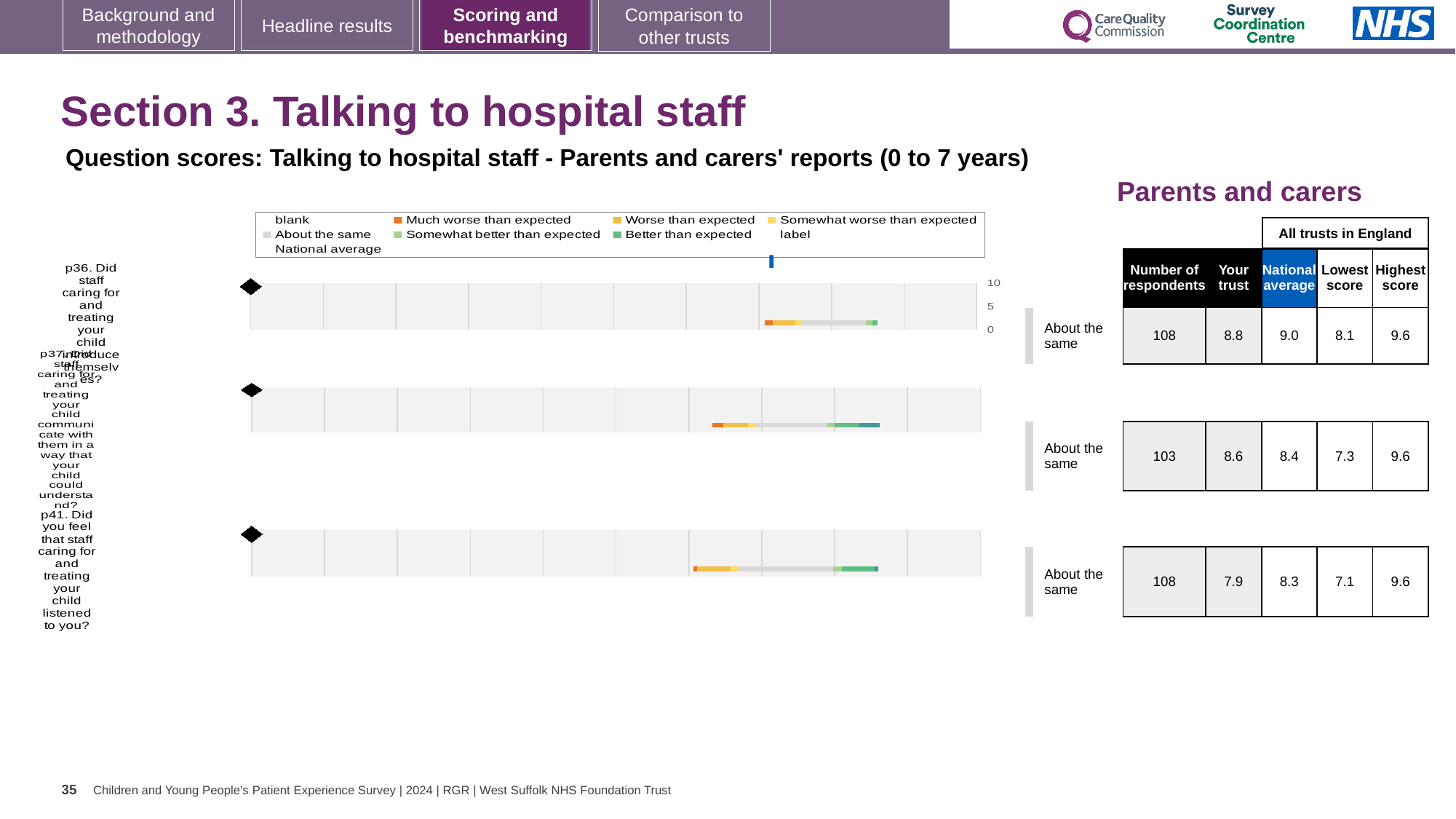
For the p37 chart (staff communicating in a way your child could understand), what is the number of respondents? 103 What type of chart is used for each question's benchmark on the slide? bar chart For the p36 chart (staff introducing themselves), what is the national average score? 9.0 For the p36 chart (staff introducing themselves), what is the 'Your trust' score? 8.8 What benchmark category label is shown next to the p41 chart (staff listened to you)? About the same For the p41 chart (staff listened to you), what is the highest score among all trusts in England? 9.6 How many benchmark charts are shown on the slide? 3 For the p41 chart (staff listened to you), what is the difference between the national average and the 'Your trust' score? 0.4 For the p37 chart (staff communicating in a way your child could understand), what is the lowest score among all trusts in England? 7.3 For the p36 chart (staff introducing themselves), which is larger: the 'Your trust' score or the national average? National average Across the three charts, which question has the lowest 'Your trust' score? p41 Across the three charts, which question has the highest 'Your trust' score? p36